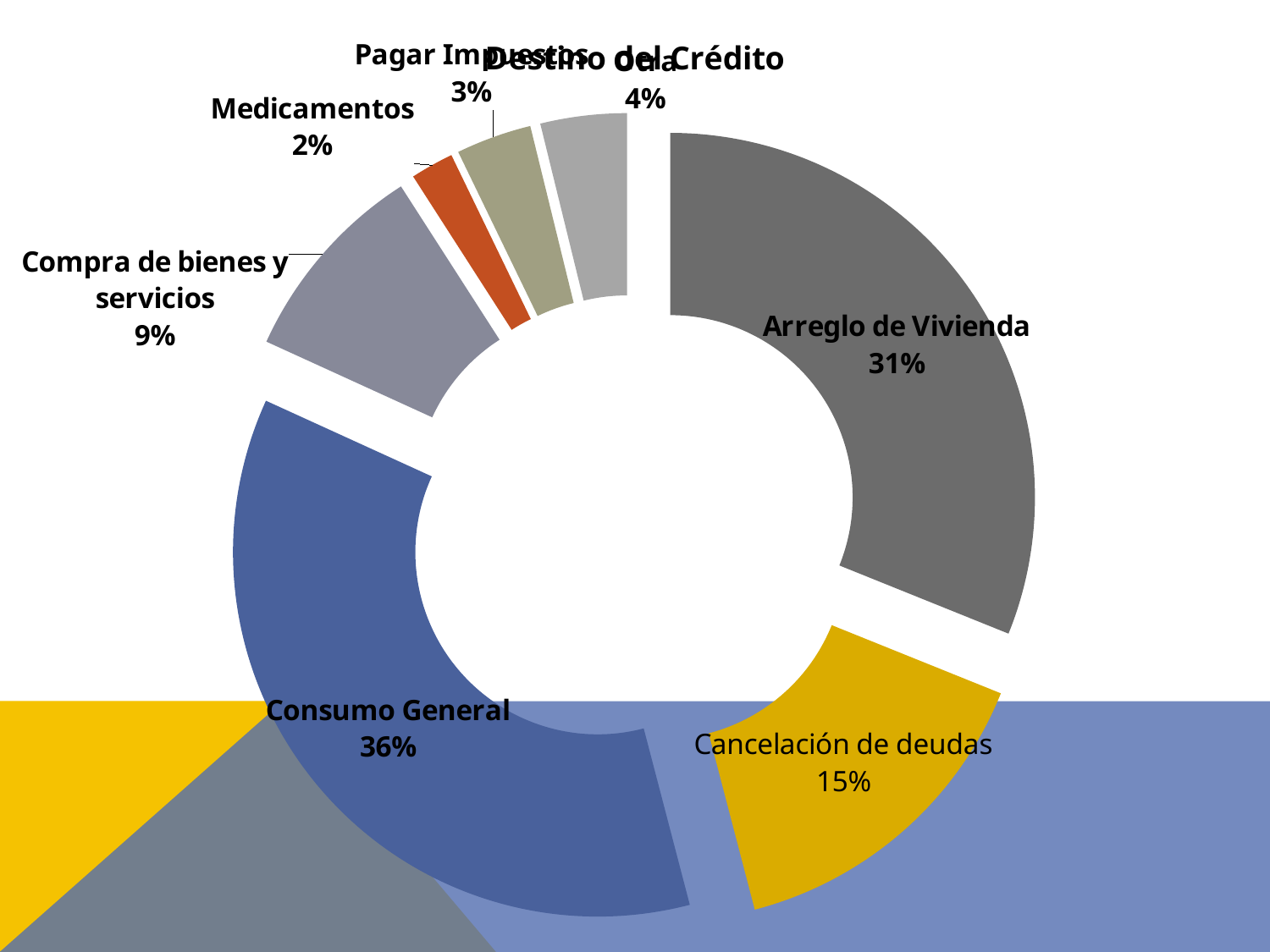
What percentage is shown for Arreglo de Vivienda? 31% What percentage is shown for Cancelación de deudas? 15% What type of chart is shown on the slide? Doughnut (pie) chart What percentage is shown for Medicamentos? 2% What percentage is shown for Pagar Impuestos? 3% What percentage is shown for Consumo General? 36% Which is larger, the share for Cancelación de deudas or the share for Compra de bienes y servicios? Cancelación de deudas What percentage is shown for Compra de bienes y servicios? 9% Which category has the smallest share of the chart? Medicamentos Which category has the largest share of the chart? Consumo General What is the difference in percentage points between Consumo General and Arreglo de Vivienda? 5 percentage points How many slices does the chart have? 7